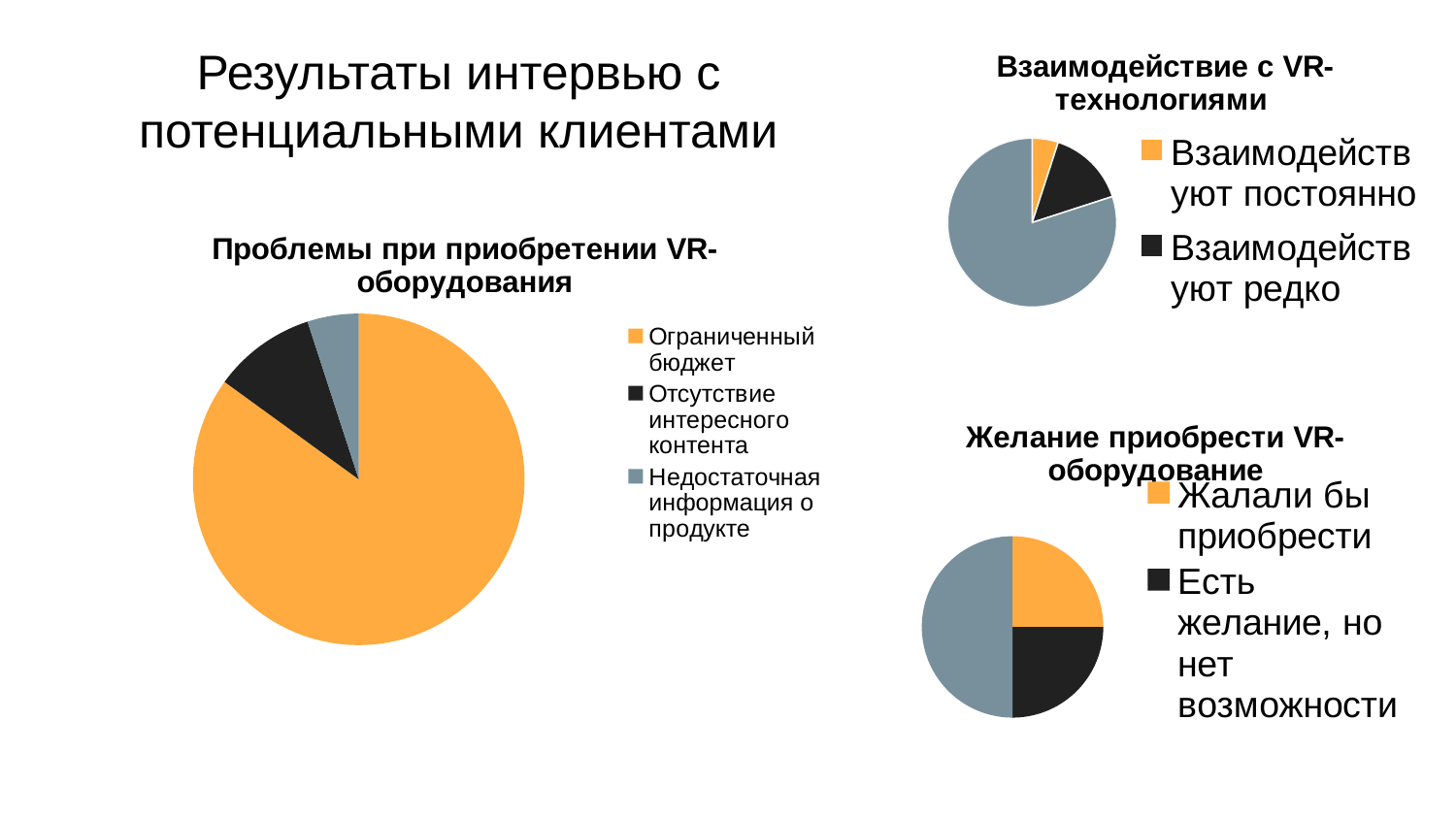
In the chart 'Проблемы при приобретении VR-оборудования', which category has the smallest slice? Недостаточная информация о продукте How many entries does the legend of the chart 'Проблемы при приобретении VR-оборудования' list? 3 What colour is the slice for 'Ограниченный бюджет' in the chart 'Проблемы при приобретении VR-оборудования'? orange In the chart 'Проблемы при приобретении VR-оборудования', which slice is larger: 'Отсутствие интересного контента' or 'Недостаточная информация о продукте'? Отсутствие интересного контента How many slices does the pie in 'Проблемы при приобретении VR-оборудования' have? 3 In the chart 'Взаимодействие с VR-технологиями', which slice is larger: 'Взаимодействуют постоянно' or 'Взаимодействуют редко'? Взаимодействуют редко How many entries does the legend of the chart 'Взаимодействие с VR-технологиями' list? 2 What kind of chart is 'Желание приобрести VR-оборудование'? pie chart In the chart 'Взаимодействие с VR-технологиями', which legend category has the smallest slice? Взаимодействуют постоянно What kind of chart is 'Проблемы при приобретении VR-оборудования'? pie chart In the chart 'Проблемы при приобретении VR-оборудования', which category has the largest slice? Ограниченный бюджет How many entries does the legend of the chart 'Желание приобрести VR-оборудование' list? 2